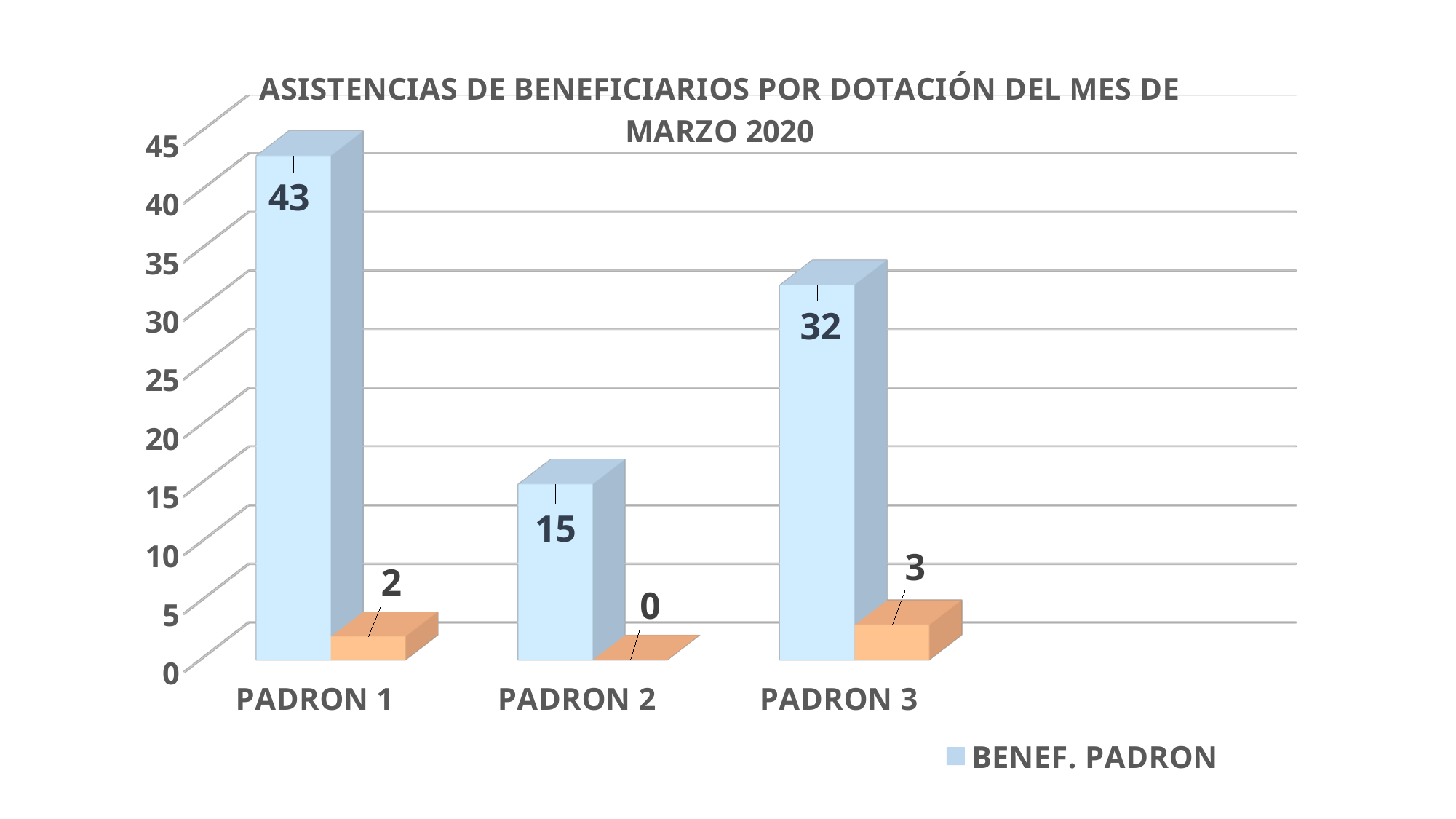
How many categories are shown on the x axis? 3 How many series does the legend list? 1 What is the BENEF. PADRON value for PADRON 1? 43 What is the difference between the BENEF. PADRON values for PADRON 3 and PADRON 2? 17 Which category has the lowest BENEF. PADRON value? PADRON 2 What is the BENEF. PADRON value for PADRON 3? 32 Which category has the highest BENEF. PADRON value? PADRON 1 What kind of chart is shown on the slide? bar chart Which has a larger BENEF. PADRON value, PADRON 2 or PADRON 3? PADRON 3 What is the BENEF. PADRON value for PADRON 2? 15 Is the BENEF. PADRON value for PADRON 1 greater or less than 40? greater What is the difference between the BENEF. PADRON values for PADRON 1 and PADRON 3? 11